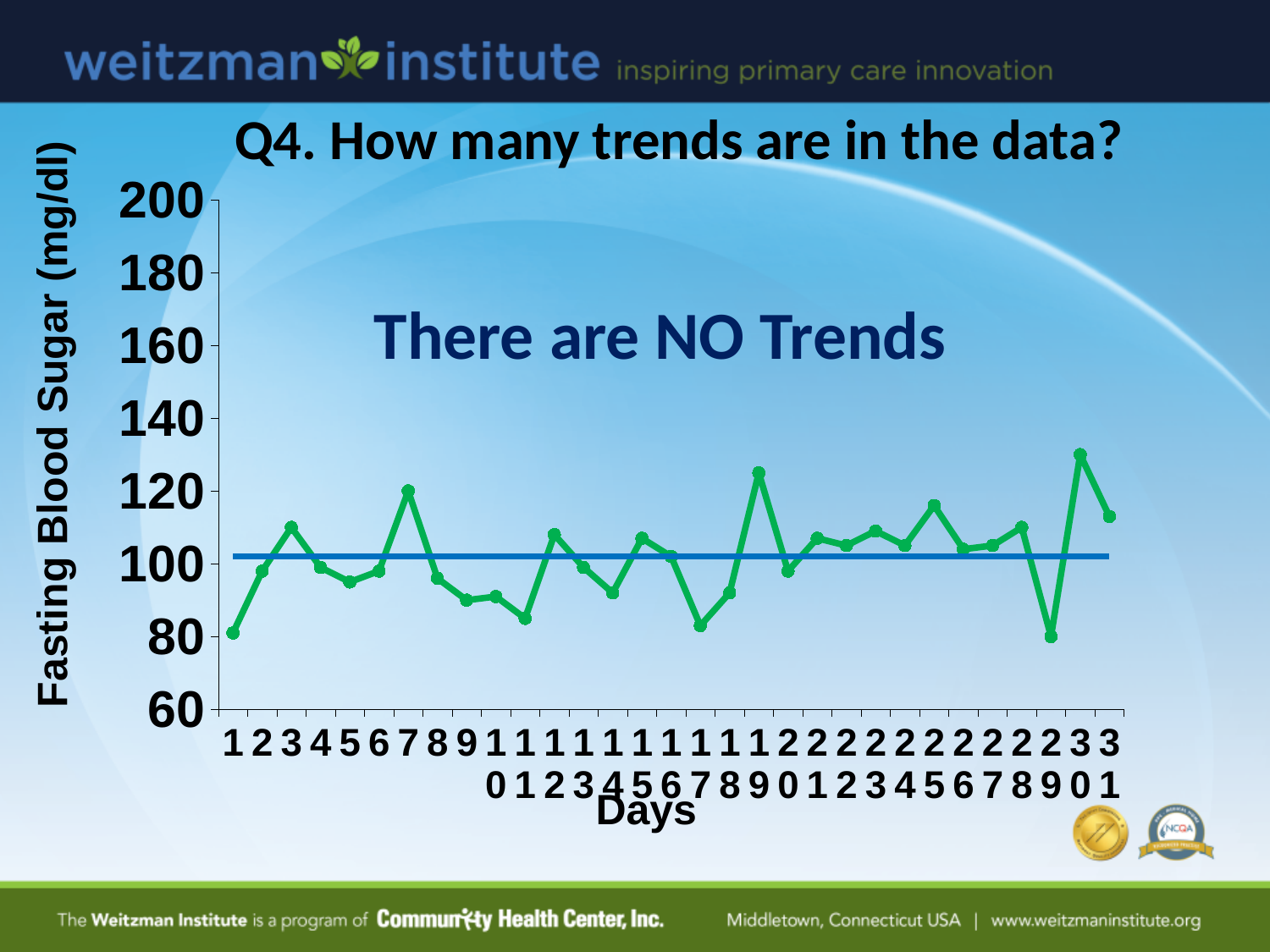
Is the fasting blood sugar value for day 30 greater or less than 120? greater Is the fasting blood sugar value for day 29 greater or less than 100? less How many days are plotted on the x axis of the chart? 31 Is the fasting blood sugar value for day 17 greater or less than 100? less What kind of chart is shown on the slide? Line chart What is the label on the y axis of the chart? Fasting Blood Sugar (mg/dl) Which has the larger fasting blood sugar value, day 7 or day 8? Day 7 According to the slide, how many trends are in the data? There are NO Trends Which has the larger fasting blood sugar value, day 19 or day 20? Day 19 Which day has the highest fasting blood sugar value? Day 30